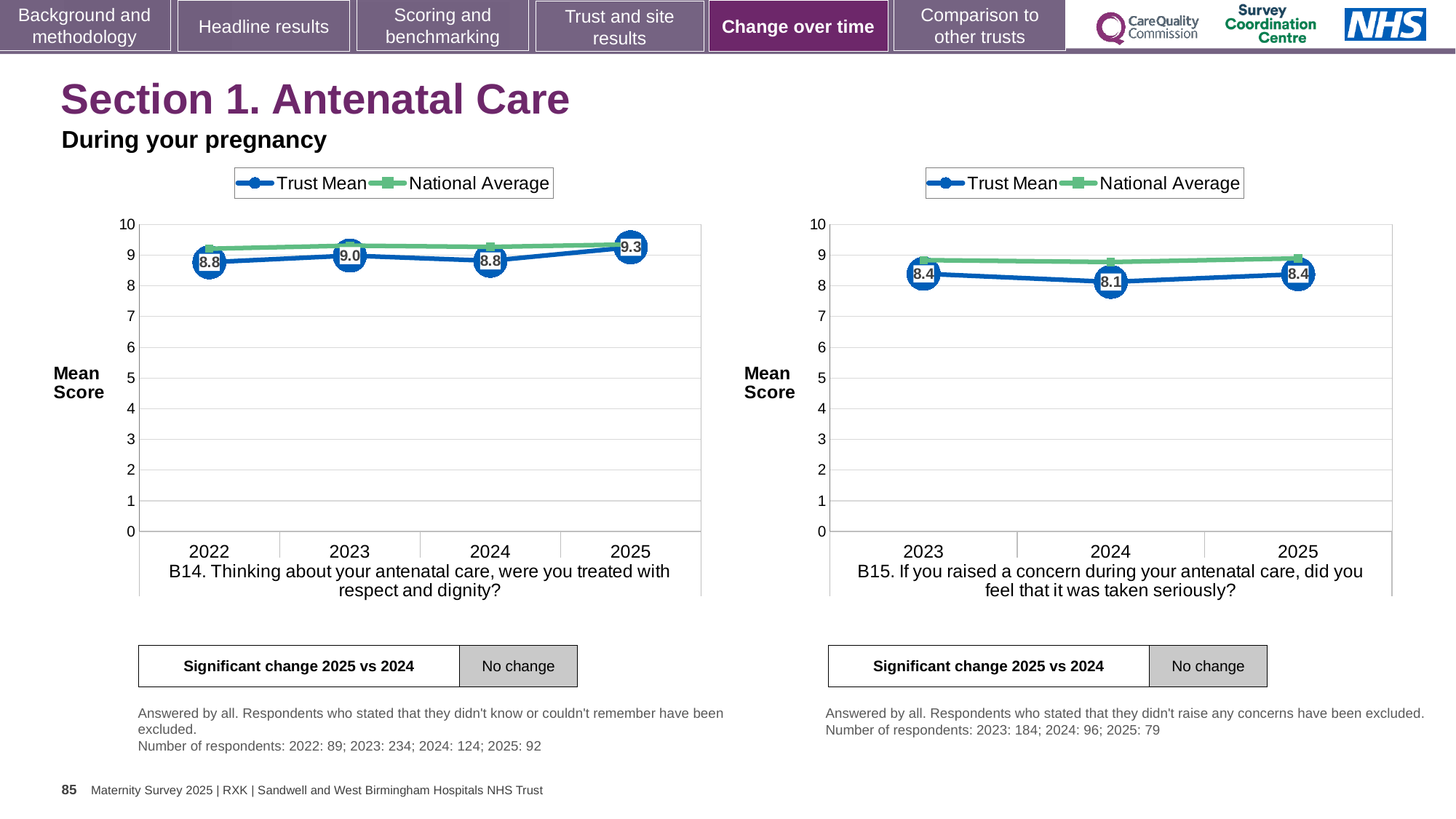
In the B14 chart on the left, is the Trust Mean score higher in 2023 or in 2025? 2025 In the B14 chart on the left, which year has the highest Trust Mean score? 2025 In the B14 chart on the left, what is the Trust Mean score for 2025? 9.3 What type of chart is used for the B14 chart on the left? Line chart In the B14 chart on the left, what is the difference between the Trust Mean scores for 2025 and 2024? 0.5 In the B15 chart on the right, what is the difference between the Trust Mean scores for 2023 and 2024? 0.3 In the B15 chart on the right, which year has the lowest Trust Mean score? 2024 In the B15 chart on the right, what is the Trust Mean score for 2024? 8.1 In the B15 chart on the right, is the National Average value for 2024 greater or less than 8? greater In the B14 chart on the left, what is the Trust Mean score for 2023? 9.0 How many series does the legend of the B14 chart on the left list? 2 How many years are shown on the x axis of the B15 chart on the right? 3